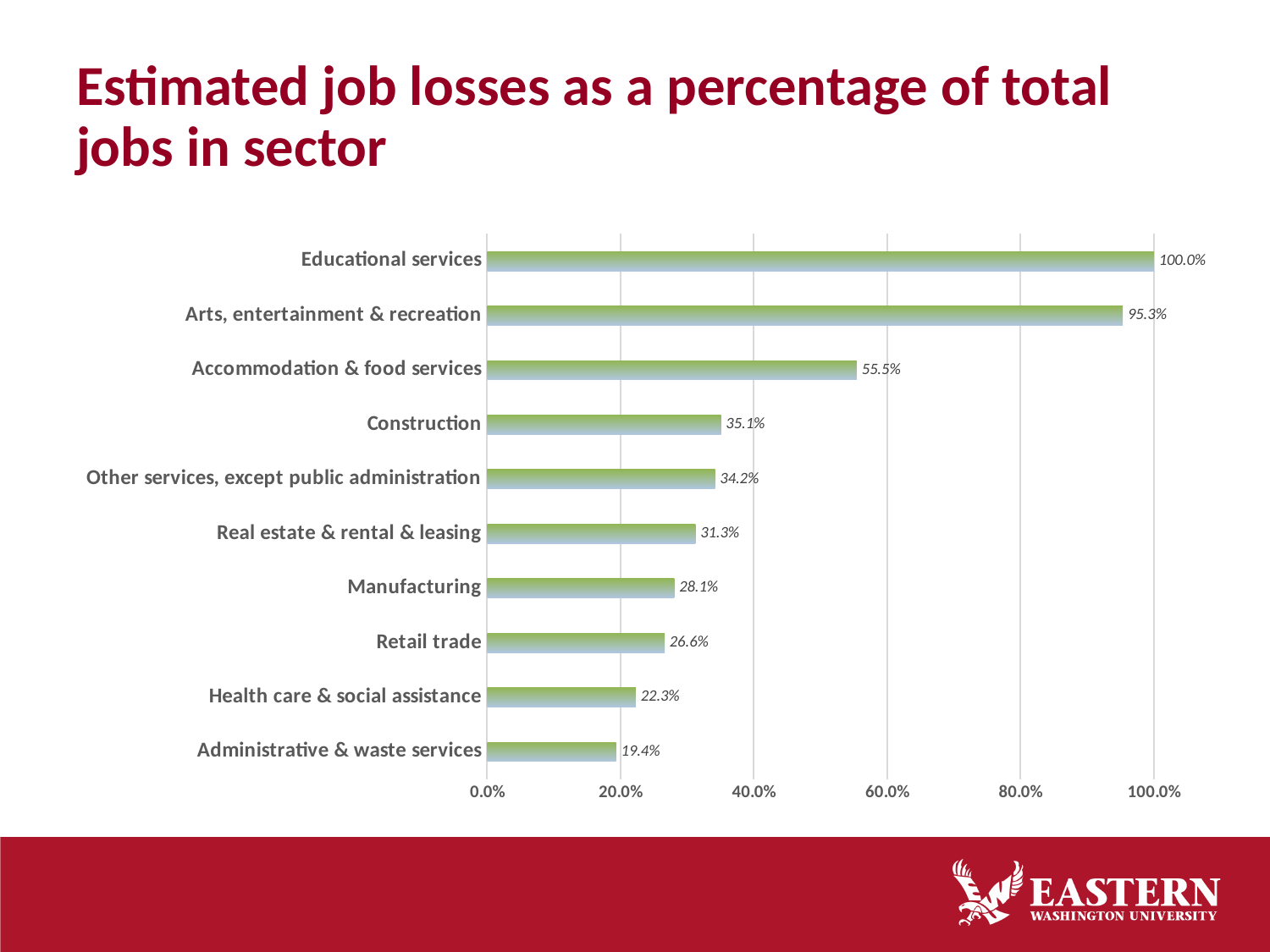
What is the estimated job loss percentage for Accommodation & food services? 55.5% Which sector has the lowest estimated job loss percentage? Administrative & waste services What is the difference between the values for Construction and Retail trade? 8.5% What is the title of the slide? Estimated job losses as a percentage of total jobs in sector What is the value shown for Health care & social assistance? 22.3% Which has a larger value, Real estate & rental & leasing or Manufacturing? Real estate & rental & leasing What kind of chart is shown on the slide? Bar chart What is the value shown for Manufacturing? 28.1% How many sectors are shown in the chart? 10 What is the difference between the values for Educational services and Arts, entertainment & recreation? 4.7% Which sector has the highest estimated job loss percentage? Educational services Is the value for Accommodation & food services greater or less than 40.0%? greater